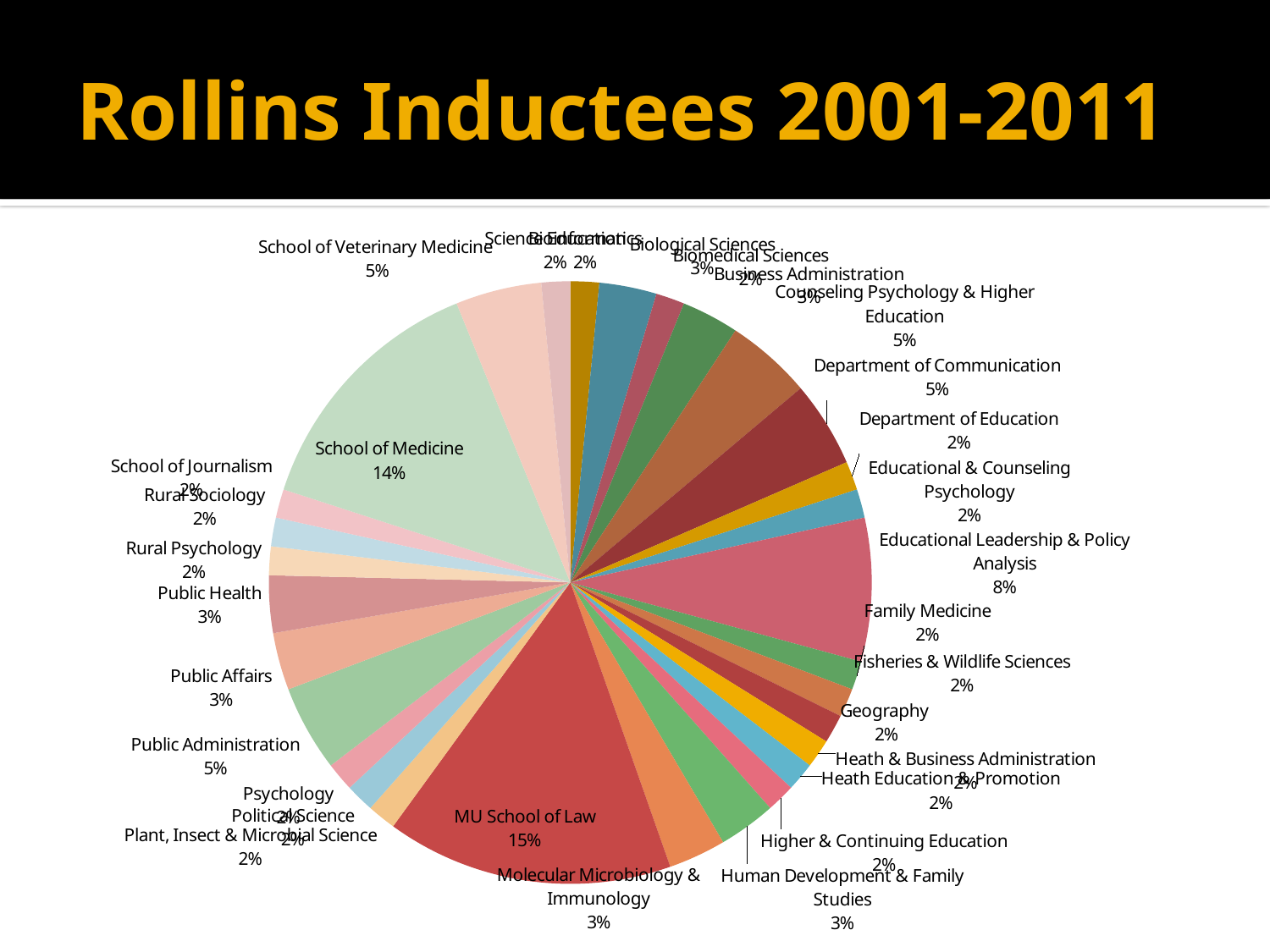
What is the value shown for Educational Leadership & Policy Analysis? 8% What kind of chart is shown on the slide? pie chart What is the difference between the MU School of Law share and the School of Medicine share? 1% Which is larger, the share for Educational Leadership & Policy Analysis or the share for Department of Communication? Educational Leadership & Policy Analysis What is the title of the slide's chart? Rollins Inductees 2001-2011 What share of the pie does MU School of Law hold? 15% Which category has the largest slice of the pie? MU School of Law What share of the pie does School of Medicine hold? 14% What is the value shown for Public Health? 3% What is the value shown for Department of Communication? 5% What is the value shown for Human Development & Family Studies? 3% What is the value shown for Public Administration? 5%